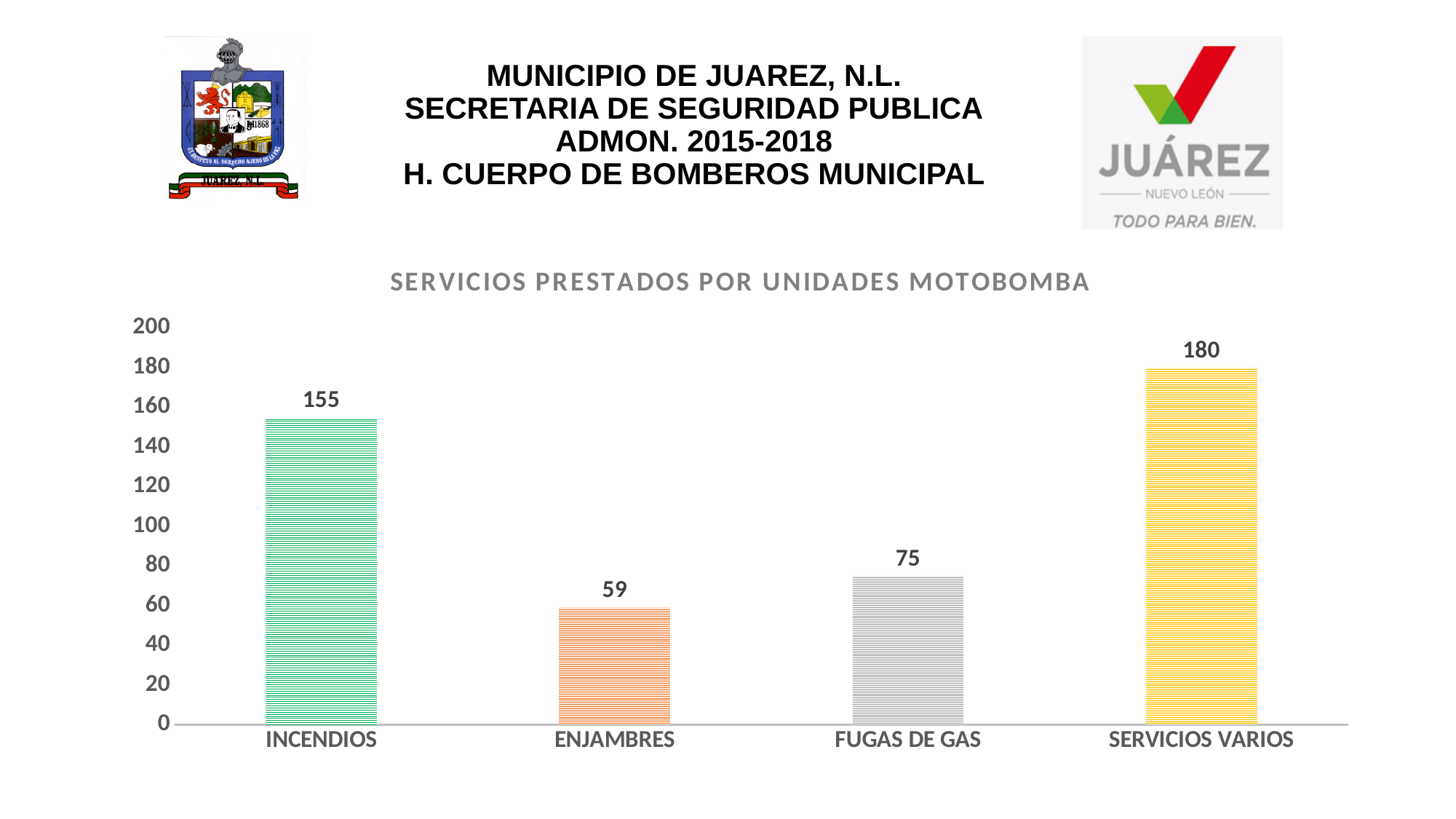
Which category has the highest value? SERVICIOS VARIOS Which category has the lowest value? ENJAMBRES What is the difference between the values for FUGAS DE GAS and ENJAMBRES? 16 What is the value for SERVICIOS VARIOS? 180 What is the value for ENJAMBRES? 59 What is the title of the chart? SERVICIOS PRESTADOS POR UNIDADES MOTOBOMBA What kind of chart is shown on the slide? bar chart What is the difference between the values for SERVICIOS VARIOS and INCENDIOS? 25 How many categories are shown on the x axis? 4 Which is larger, the value for INCENDIOS or the value for FUGAS DE GAS? INCENDIOS What is the value for FUGAS DE GAS? 75 What is the value for INCENDIOS? 155